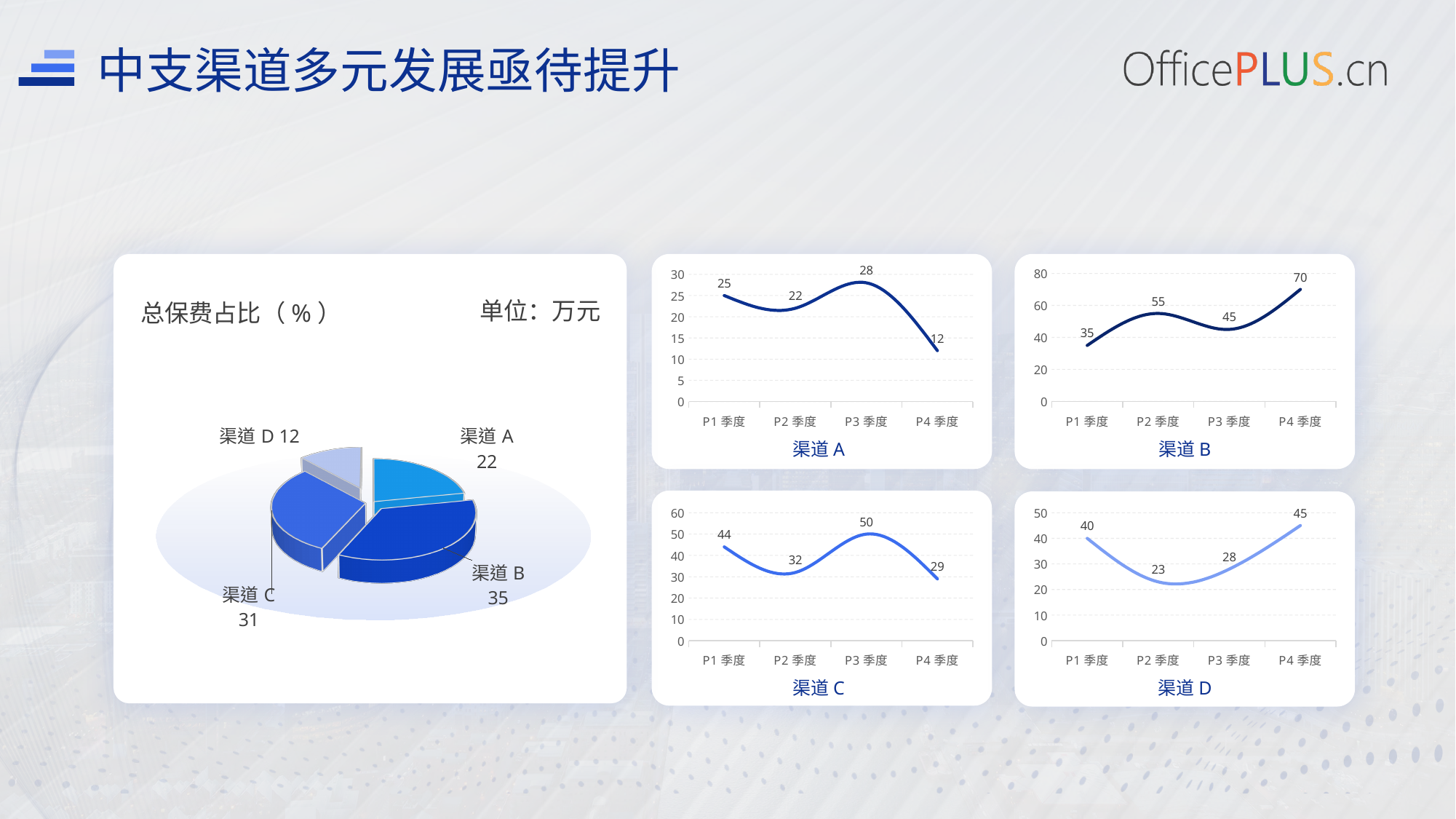
In the 渠道 D line chart, what is the value for P2 季度? 23 In the 渠道 D line chart, do the values rise or fall from P2 季度 to P4 季度? rise In the 渠道 C line chart, what is the value for P3 季度? 50 In the pie chart 总保费占比（%）, which channel has the smallest share? 渠道 D What kind of chart is the 渠道 B chart? line chart In the 渠道 A line chart, which quarter has the lowest value? P4 季度 In the 渠道 B line chart, what is the difference between P4 季度 and P1 季度? 35 In the 渠道 A line chart, what is the value for P3 季度? 28 In the 渠道 C line chart, which is larger, P1 季度 or P2 季度? P1 季度 In the pie chart 总保费占比（%）, how many slices are there? 4 In the 渠道 B line chart, which quarter has the highest value? P4 季度 In the pie chart 总保费占比（%）, what is the value for 渠道 B? 35